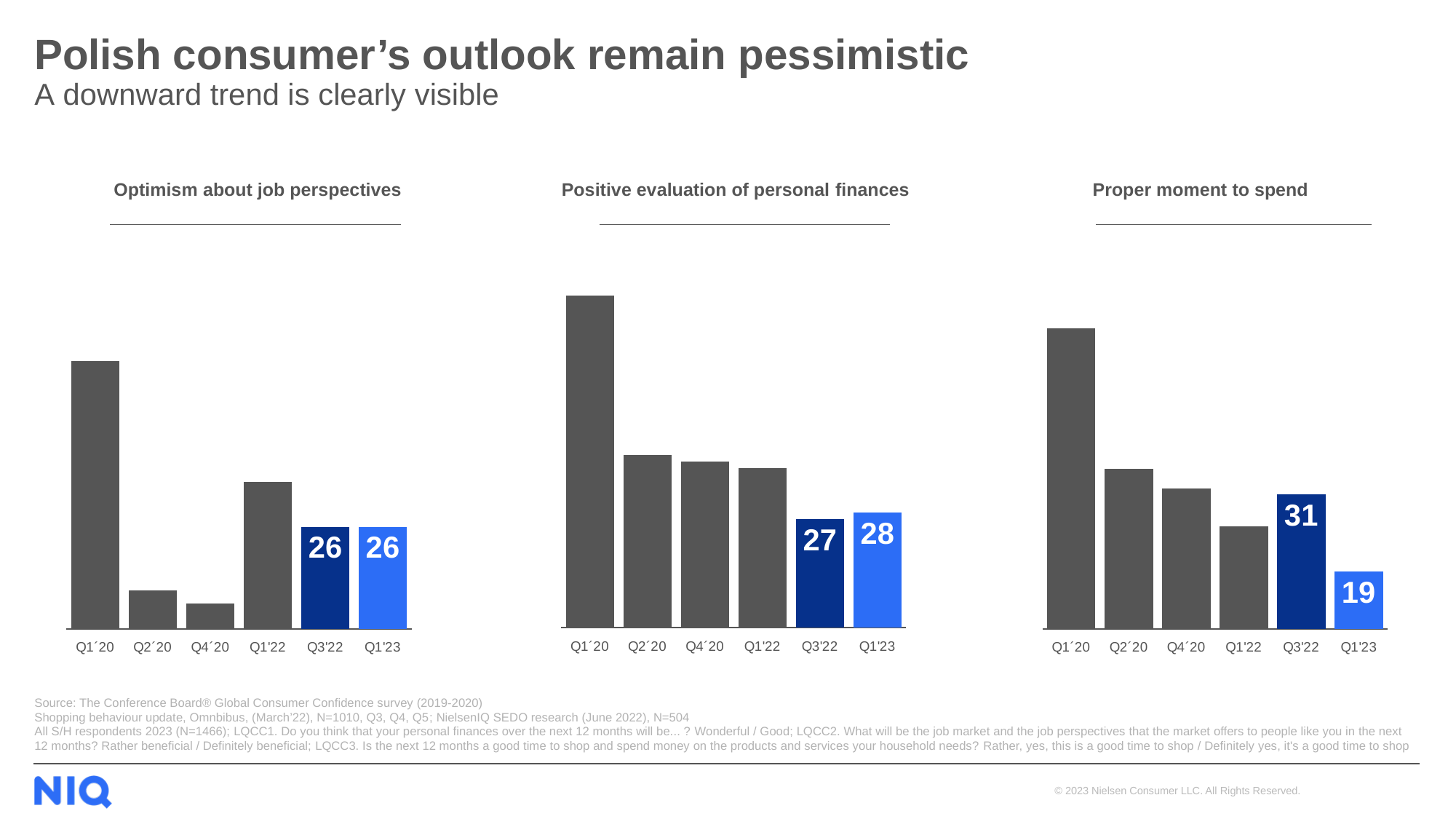
In the 'Positive evaluation of personal finances' chart, which period has the lowest value? Q3'22 In the 'Positive evaluation of personal finances' chart, what is the value for Q1'23? 28 In the 'Optimism about job perspectives' chart, what is the value for Q3'22? 26 In the 'Proper moment to spend' chart, what is the value for Q1'23? 19 In the 'Positive evaluation of personal finances' chart, what is the value for Q3'22? 27 In the 'Optimism about job perspectives' chart, which is larger, the value for Q1´20 or the value for Q1'22? Q1´20 In the 'Optimism about job perspectives' chart, which period has the highest value? Q1´20 In the 'Positive evaluation of personal finances' chart, what is the difference between the Q1'23 value and the Q3'22 value? 1 In the 'Optimism about job perspectives' chart, what is the value for Q1'23? 26 In the 'Proper moment to spend' chart, how many periods are shown on the x axis? 6 In the 'Proper moment to spend' chart, what is the difference between the Q3'22 value and the Q1'23 value? 12 What type of chart is used for 'Proper moment to spend'? Bar chart